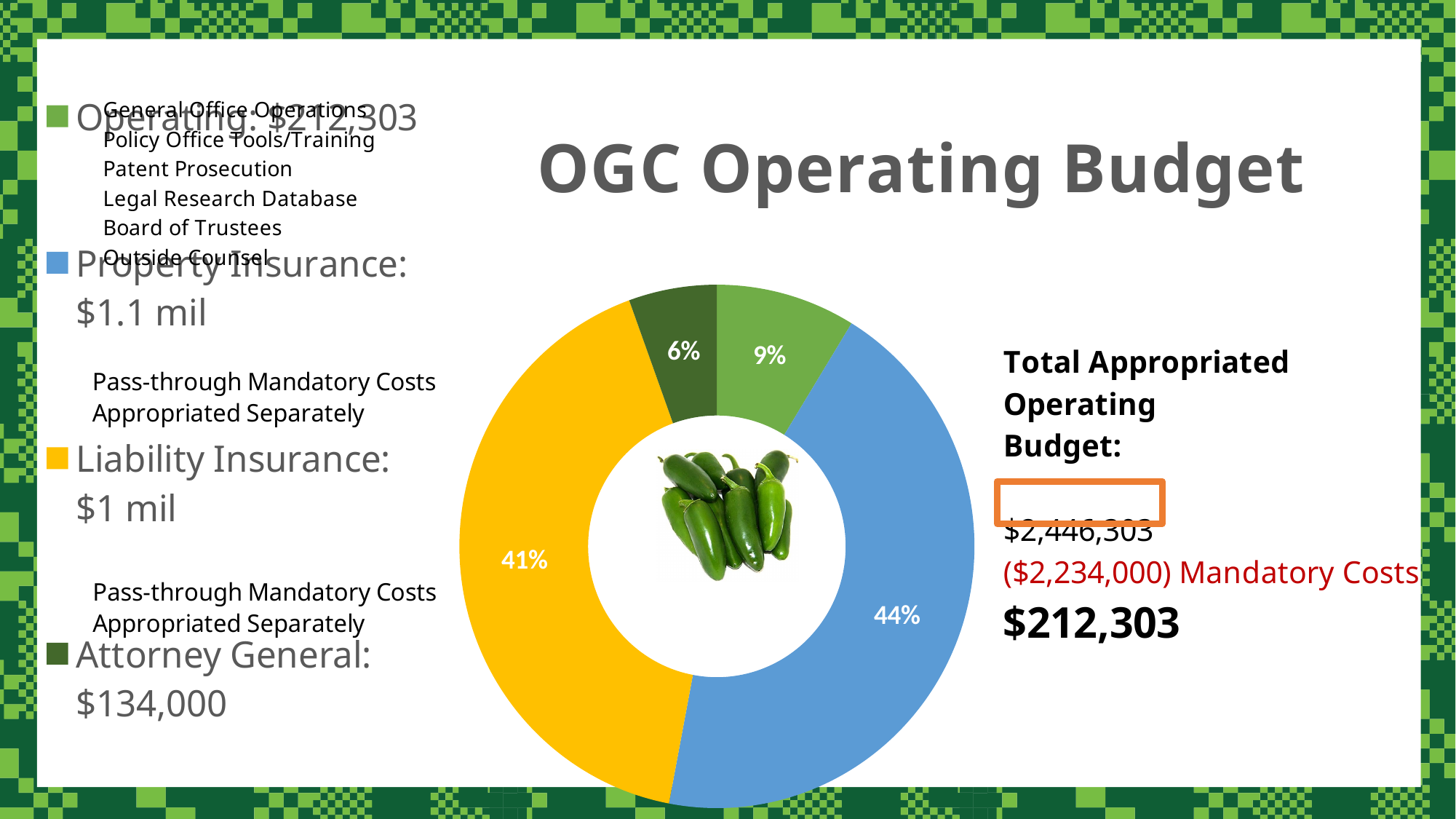
What share of the chart does Operating represent? 9% What kind of chart is shown on the slide? Pie chart (donut) Which category has the largest slice of the chart? Property Insurance What share of the chart does Liability Insurance represent? 41% What is the difference in percentage points between the Property Insurance slice and the Liability Insurance slice? 3 percentage points What share of the chart does Attorney General represent? 6% Which is larger, the Operating slice or the Attorney General slice? Operating Which category has the smallest slice of the chart? Attorney General What colour is the Liability Insurance slice? Yellow What is the title of the chart? OGC Operating Budget How many slices does the chart have? 4